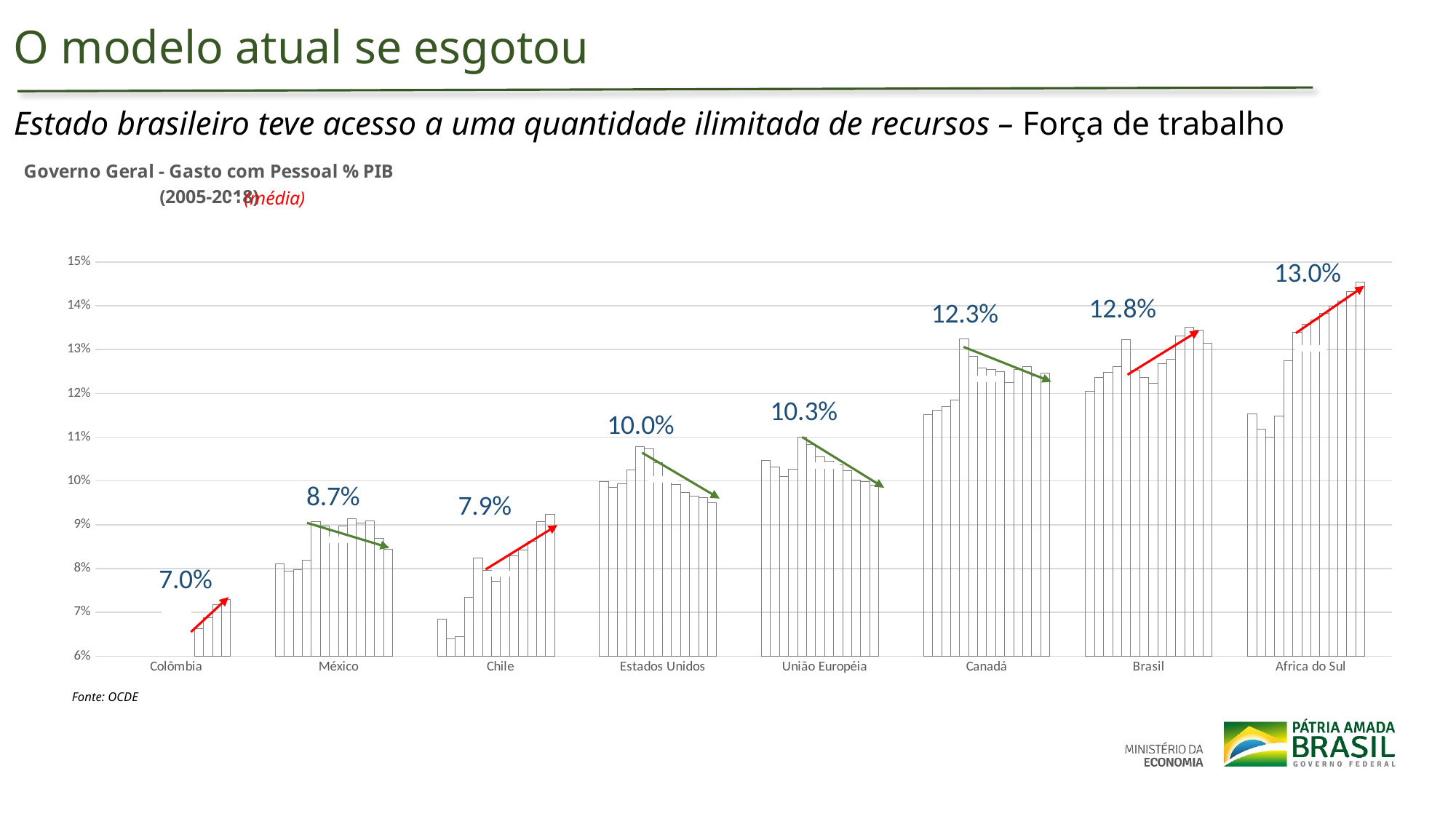
What average value is labelled for Colômbia? 7.0% What average value is labelled for União Européia? 10.3% Which country or region has the lowest labelled average? Colômbia How many countries or regions are shown on the x axis? 8 Is the labelled average for Estados Unidos greater or less than 9%? greater Which has a higher labelled average, México or Chile? México Which country or region has the highest labelled average? Africa do Sul What kind of chart is shown on the slide? Bar chart What is the difference between the labelled averages for Brasil and Canadá? 0.5 percentage points What source is cited below the chart? OCDE What is the average general government personnel spending as % of GDP shown for Brasil? 12.8% Does the trend arrow drawn over the Brasil bars indicate rising or falling values? Rising